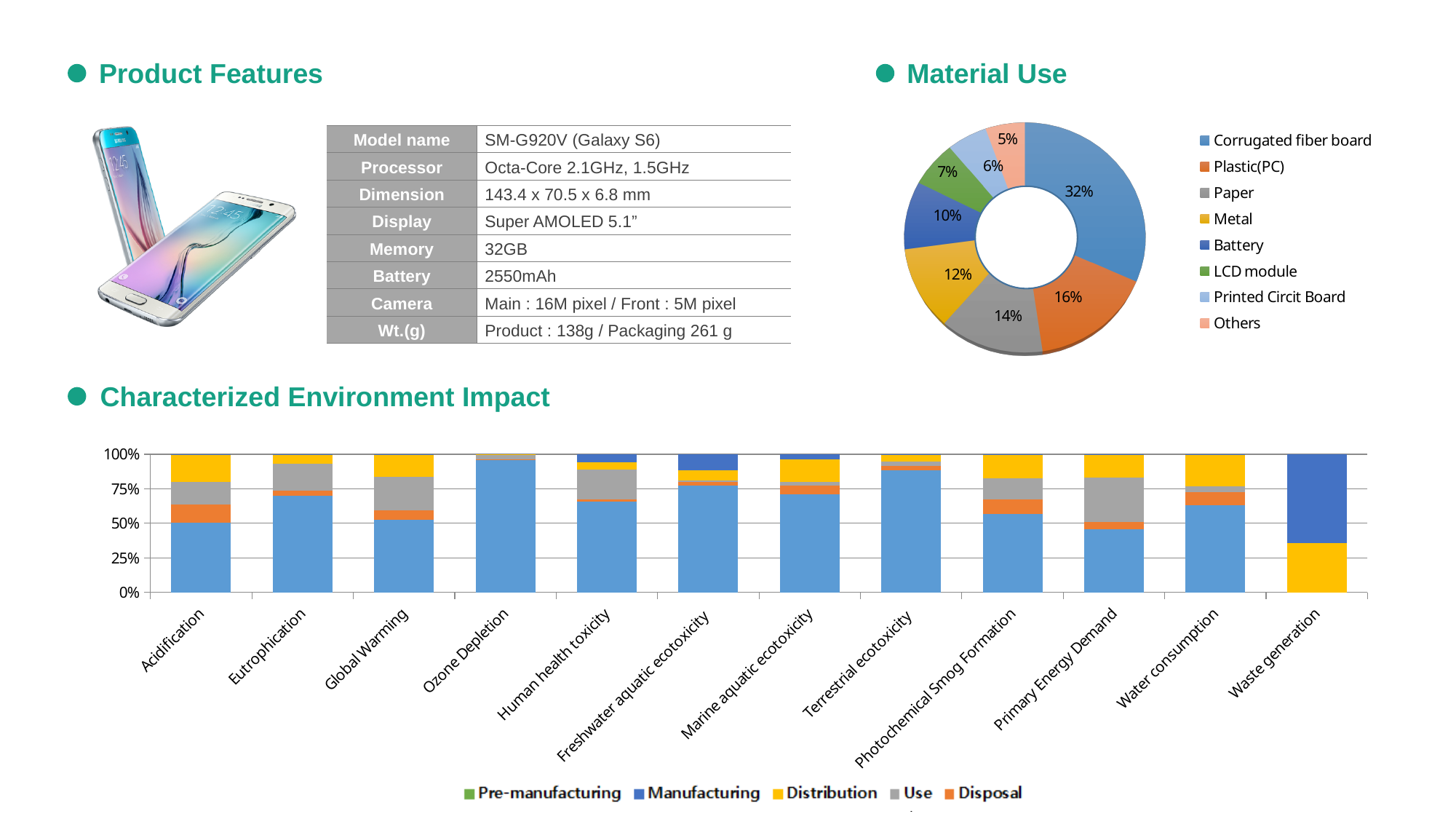
In the Material Use chart, what percentage is shown for Plastic(PC)? 16% How many categories are shown on the x axis of the Characterized Environment Impact chart? 12 How many entries does the legend of the Material Use chart list? 8 In the Material Use chart, what share does Corrugated fiber board have? 32% How many series does the legend of the Characterized Environment Impact chart list? 5 In the Material Use chart, what is the difference between the Paper share and the Metal share? 2% In the Characterized Environment Impact chart, is the yellow Distribution segment for Waste generation greater or less than 25%? greater In the Material Use chart, which category has the smallest share? Others In the Material Use chart, which material has the largest share? Corrugated fiber board In the Material Use chart, which is larger, LCD module or Printed Circit Board? LCD module What kind of chart is the Material Use chart? Doughnut chart In the Material Use chart, what percentage is shown for Battery? 10%